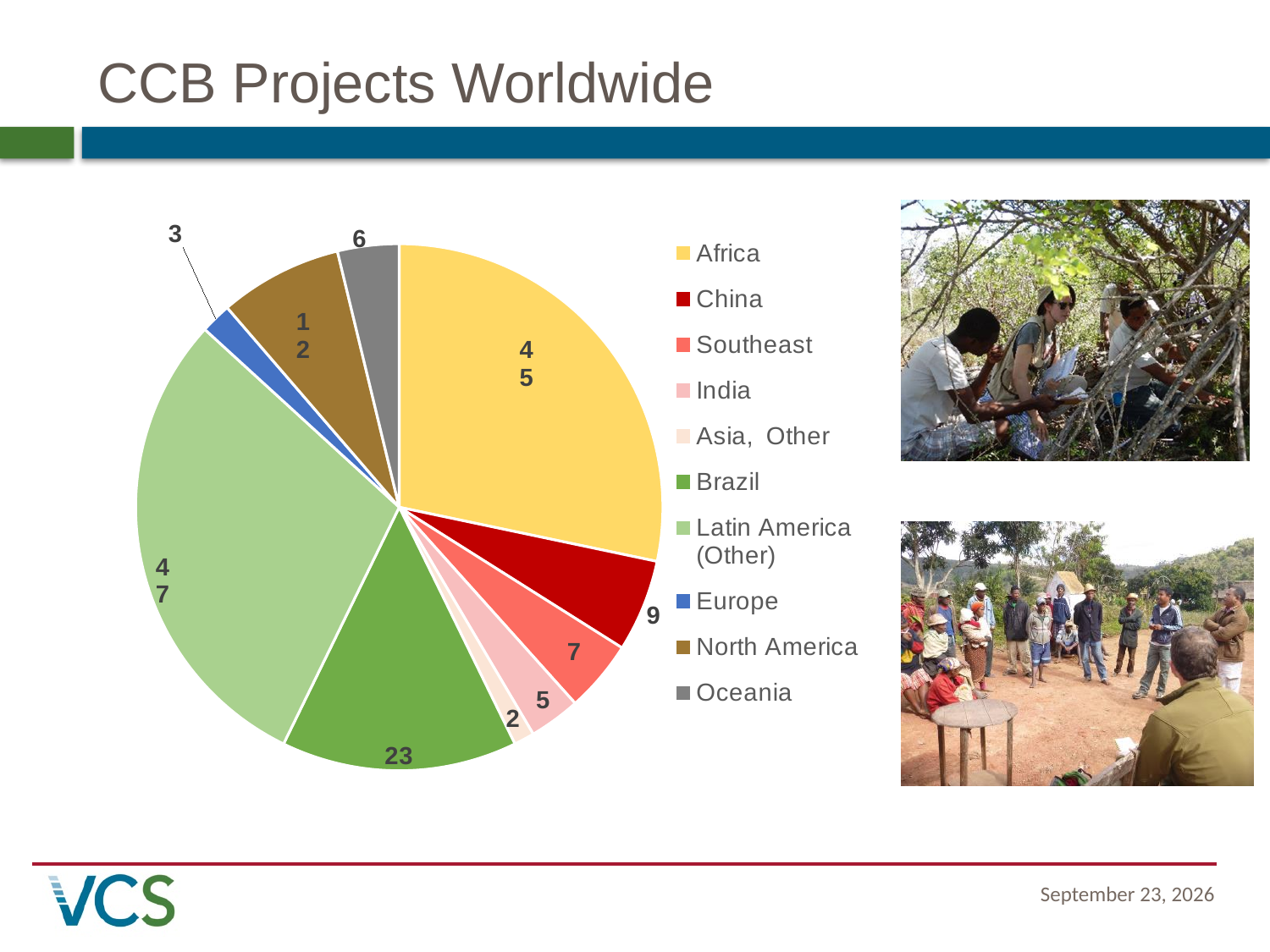
What is the value for Brazil in the pie chart? 23 Which is larger, the value for Southeast or the value for India? Southeast How many categories does the pie chart's legend list? 10 What colour is the Africa slice in the pie chart? yellow Which category has the largest slice in the pie chart? Latin America (Other) What is the value for Oceania in the pie chart? 6 What kind of chart is shown on the slide? pie chart What is the value for Southeast in the pie chart? 7 Which category has the smallest slice in the pie chart? Asia, Other What is the difference between the values for Brazil and China? 14 What is the value for Europe in the pie chart? 3 What is the value for China in the pie chart? 9